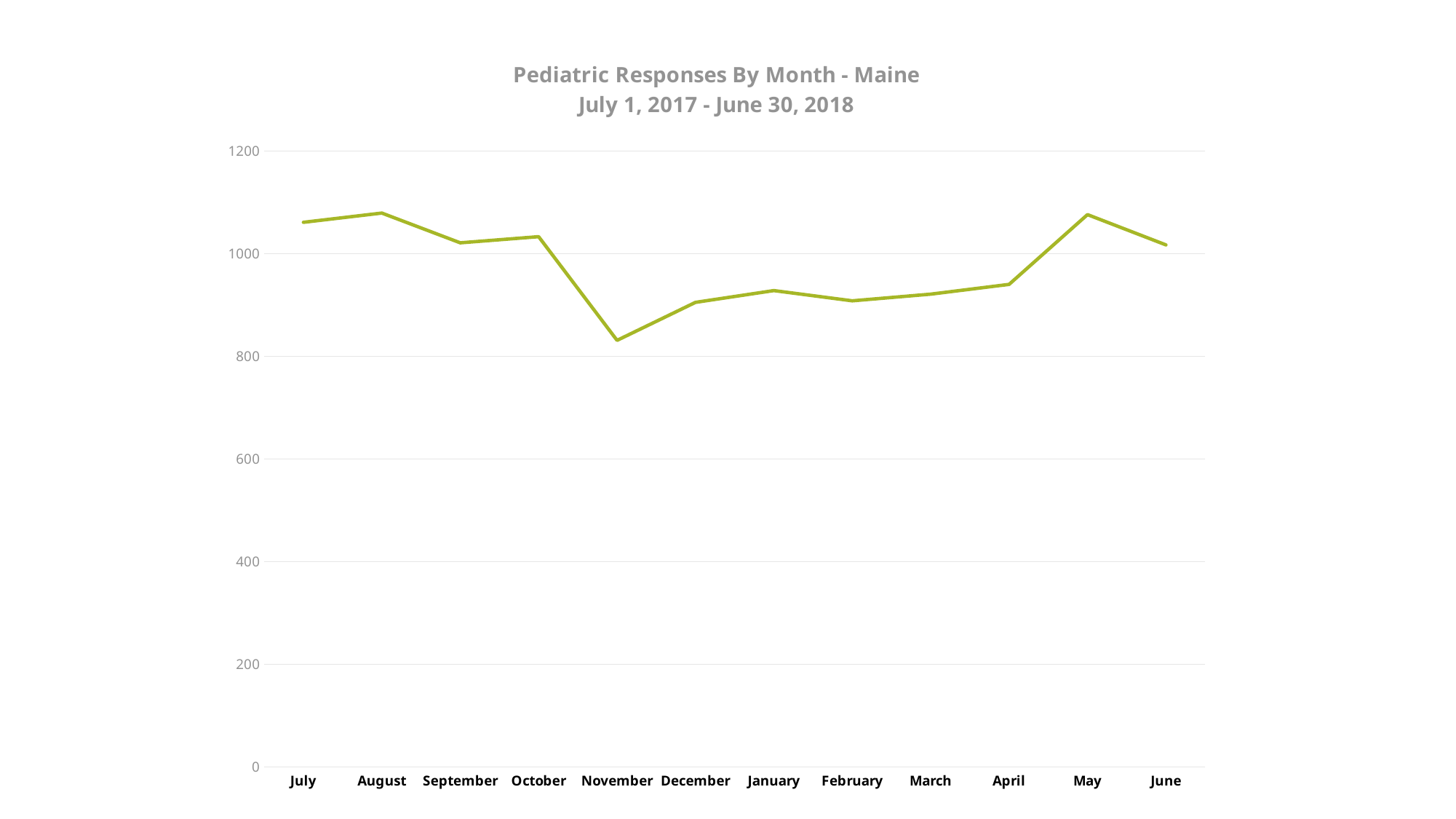
Is the value for July greater or less than 1000? greater Which is larger, the value for July or the value for December? July Is the value for November greater or less than 1000? less Do the values rise or fall from October to November? fall Is the value for May greater or less than 1000? greater Which is larger, the value for May or the value for November? May What is the title of the chart? Pediatric Responses By Month - Maine July 1, 2017 - June 30, 2018 What kind of chart is shown on the slide? line chart Which month has the lowest number of pediatric responses? November How many months are plotted on the x axis? 12